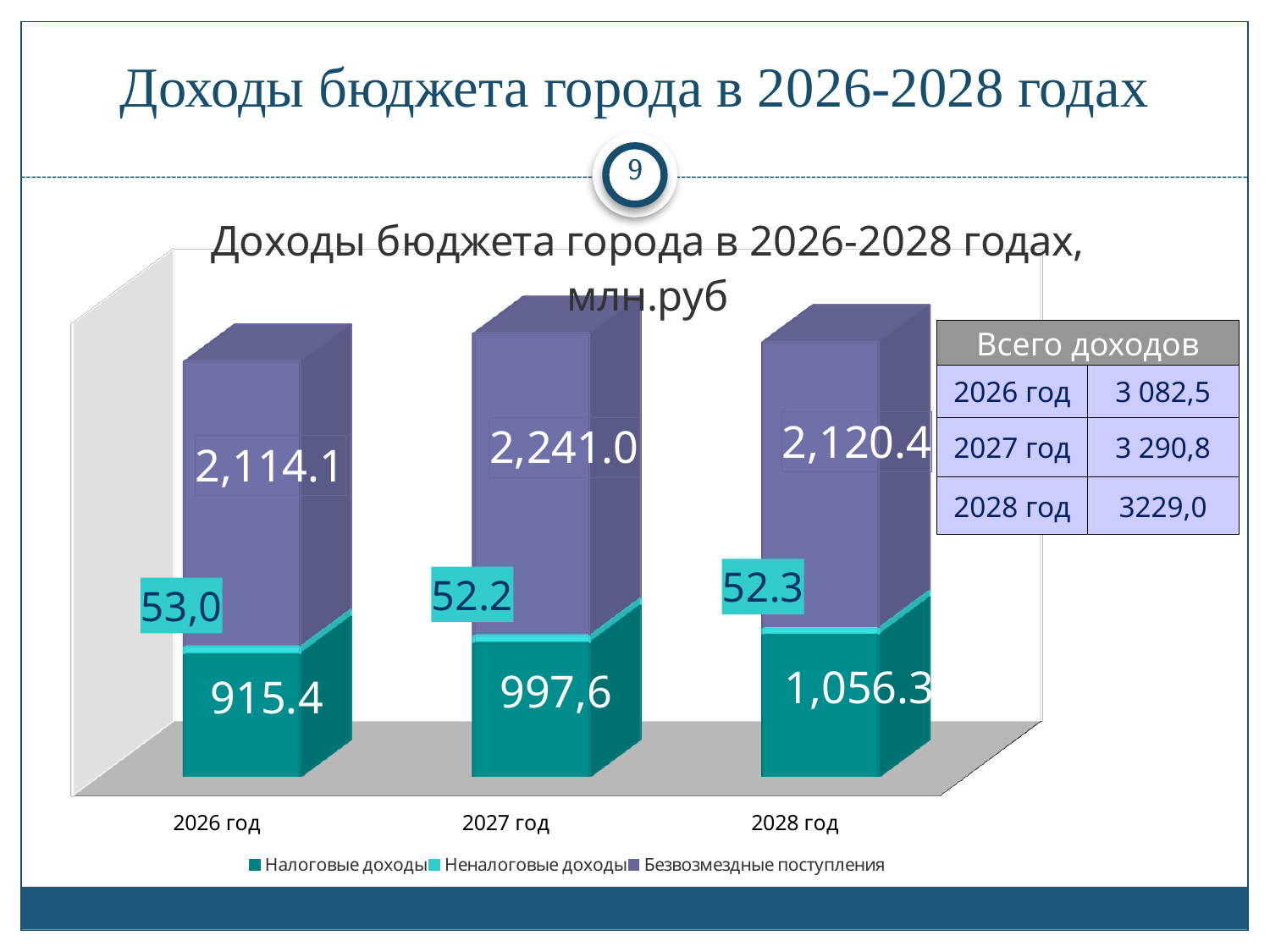
In which year are Безвозмездные поступления the highest? 2027 год Do Налоговые доходы rise or fall from 2026 год to 2028 год? Rise What kind of chart is shown on the slide? Stacked bar chart In which year are Налоговые доходы the lowest? 2026 год What is the difference in Налоговые доходы between 2028 год and 2027 год? 58.7 By how much do Безвозмездные поступления in 2027 год exceed those in 2026 год? 126.9 What is the value of Безвозмездные поступления for 2027 год? 2,241.0 What is the value of Налоговые доходы for 2026 год? 915.4 What is the value of Неналоговые доходы for 2028 год? 52.3 Which year has larger Налоговые доходы, 2027 год or 2028 год? 2028 год How many series does the chart legend list? 3 How many years (categories) are shown on the x axis of the chart? 3